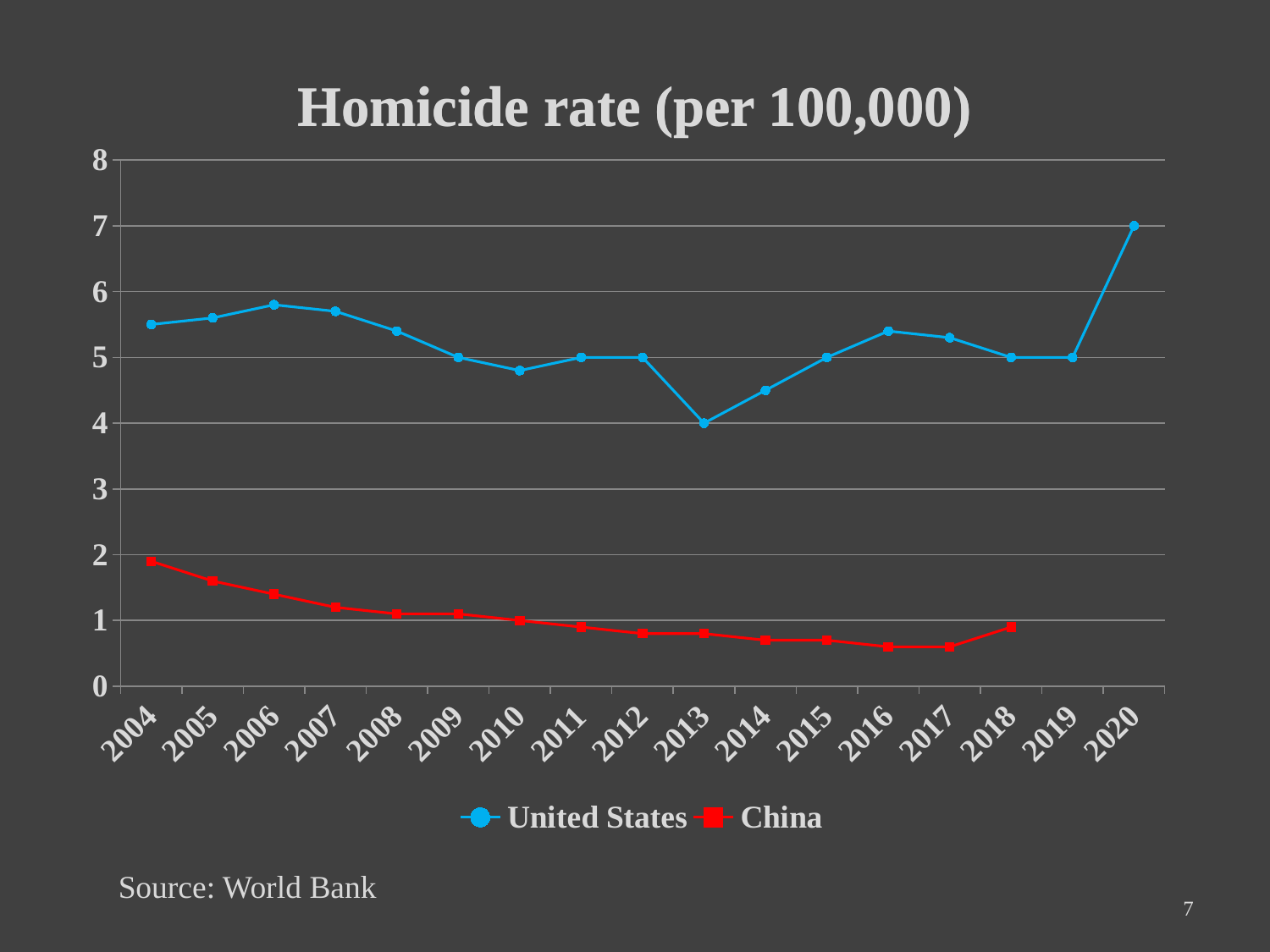
Is China's homicide rate in 2016 greater or less than 1? less In which year is the United States homicide rate highest? 2020 What is the difference between the United States homicide rate in 2020 and in 2013? 3 Which series has the higher homicide rate in 2012, United States or China? United States What is the homicide rate for the United States in 2020? 7 What kind of chart is shown on the slide? line chart What is the homicide rate for the United States in 2013? 4 Is the United States homicide rate in 2006 greater or less than 5? greater In which year is China's homicide rate highest? 2004 In which year is the United States homicide rate lowest? 2013 How many series does the legend list? 2 Does China's homicide rate generally rise or fall from 2004 to 2017? fall